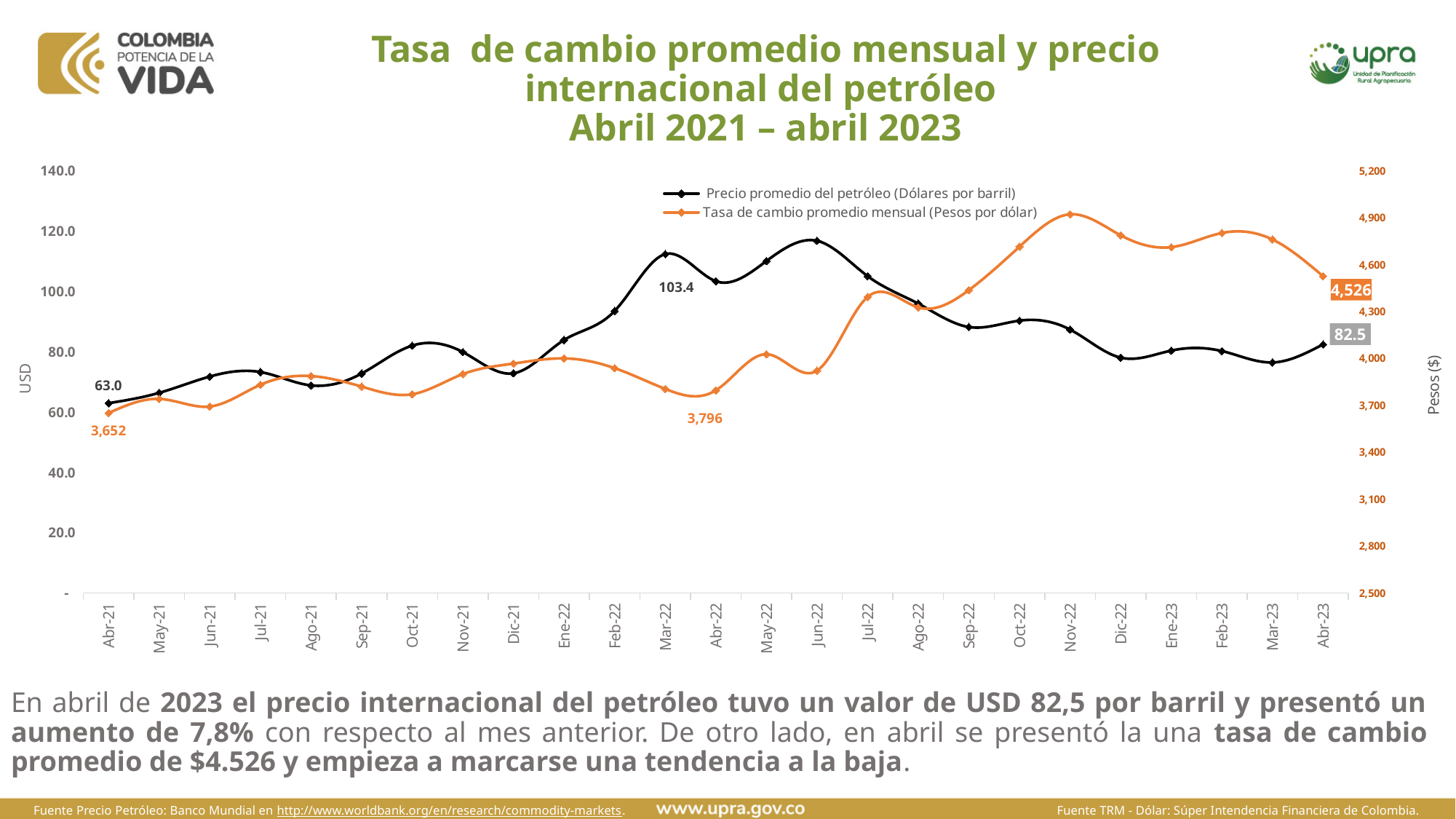
What is the labelled value of the exchange rate (Tasa de cambio promedio mensual) in Abr-21? 3,652 What type of chart is shown on the slide? Line chart What is the labelled value of the oil price in Abr-23? 82.5 How many months are plotted along the x axis? 25 By how much did the labelled exchange rate increase from Abr-21 to Abr-23? 874 How many series does the legend list? 2 What is the label of the left vertical axis? USD What is the difference between the labelled oil price in Abr-23 and in Abr-21? 19.5 Is the oil price in Jun-22 greater or less than 100.0? greater What is the labelled value of the exchange rate in Abr-23? 4,526 What is the labelled value of the oil price (Precio promedio del petróleo) in Abr-21? 63.0 In which month does the exchange rate series reach its highest point? Nov-22